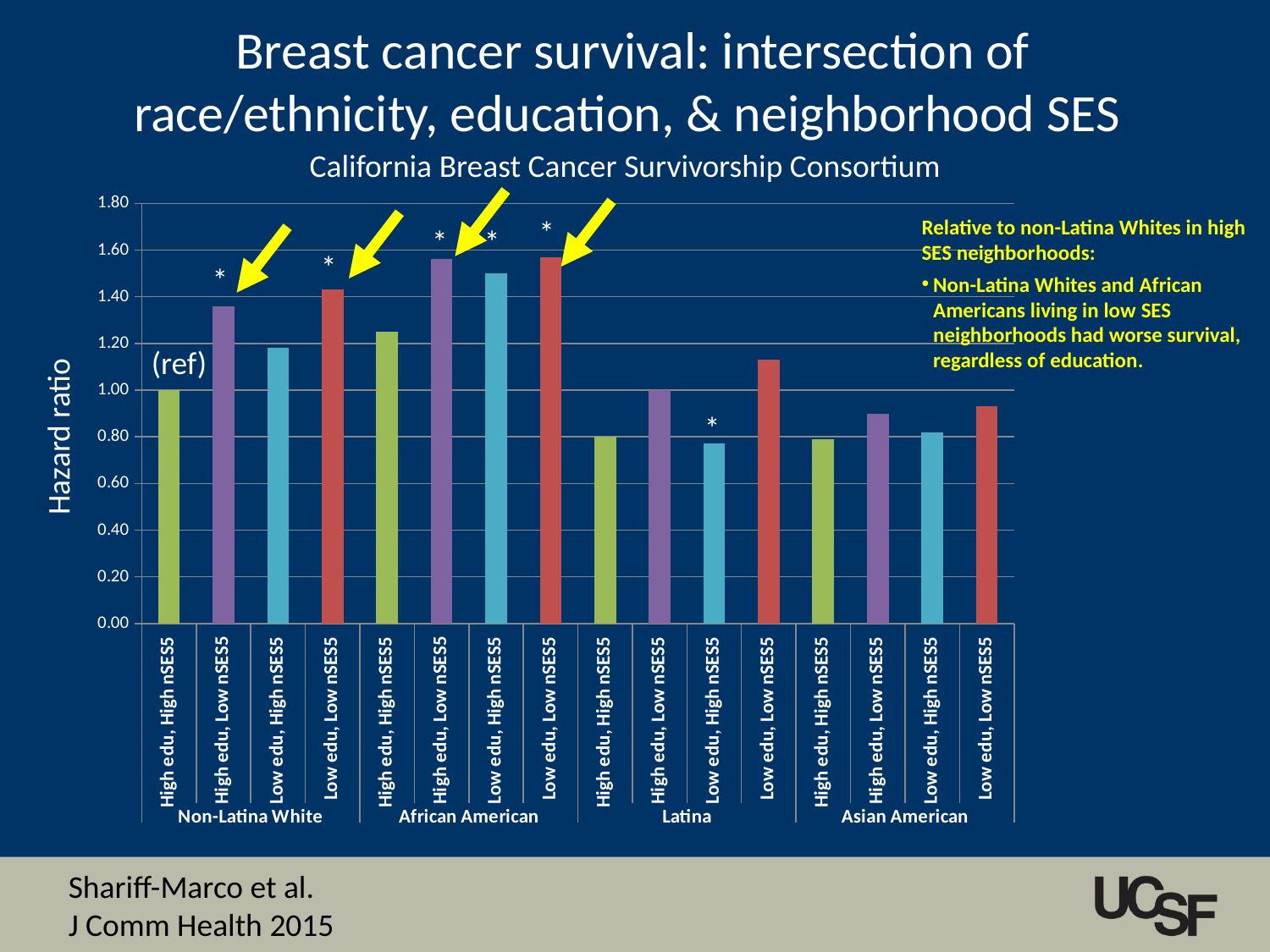
What is the hazard ratio for the reference group, Non-Latina White with High edu, High nSES? 1.00 Which consortium is named in the chart's subtitle? California Breast Cancer Survivorship Consortium What kind of chart is shown on the slide? Bar chart Within the Non-Latina White group, which has the higher hazard ratio: High edu, Low nSES or Low edu, High nSES? High edu, Low nSES Is the hazard ratio for Non-Latina White, Low edu, Low nSES greater or less than 1.20? greater Is the hazard ratio for Asian American, Low edu, Low nSES greater or less than 1.00? less How many race/ethnicity groups are shown along the x axis of the chart? 4 Is the hazard ratio for Latina, Low edu, High nSES greater or less than 1.00? less How many bars are plotted in the chart? 16 Which has the higher hazard ratio: African American, High edu, High nSES or Latina, Low edu, Low nSES? African American, High edu, High nSES What is the label on the y axis of the chart? Hazard ratio